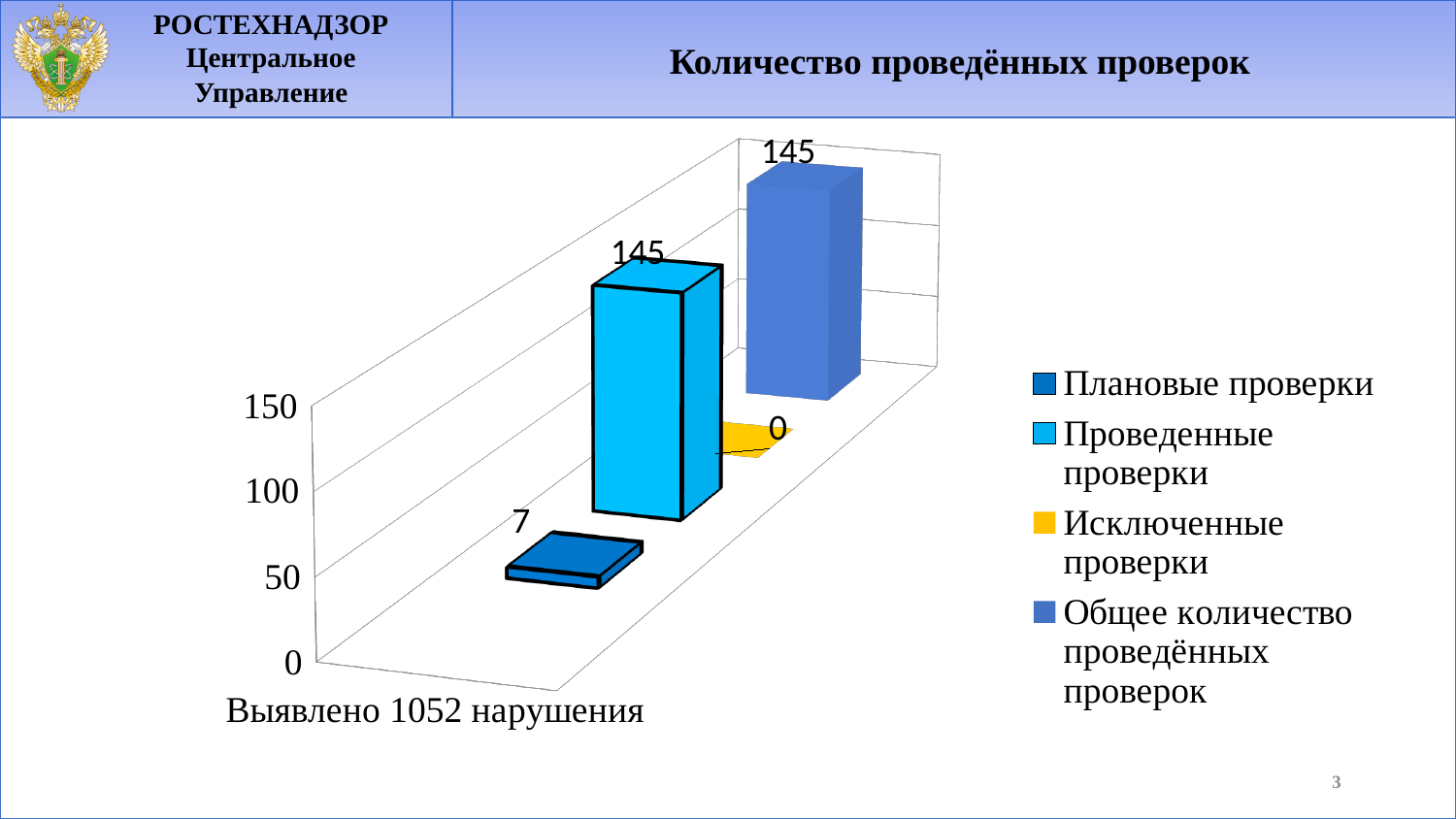
What is the title of the chart? Количество проведённых проверок What is the difference between Проведенные проверки and Плановые проверки? 138 What kind of chart is shown on the slide? bar chart What is the value for Исключенные проверки? 0 What is the value for Плановые проверки? 7 What is the value for Проведенные проверки? 145 Which is larger, Плановые проверки or Проведенные проверки? Проведенные проверки Which series has the lowest value? Исключенные проверки Is the value for Общее количество проведённых проверок greater or less than 100? greater How many series does the legend list? 4 What is the value for Общее количество проведённых проверок? 145 Is the value for Плановые проверки greater or less than 50? less